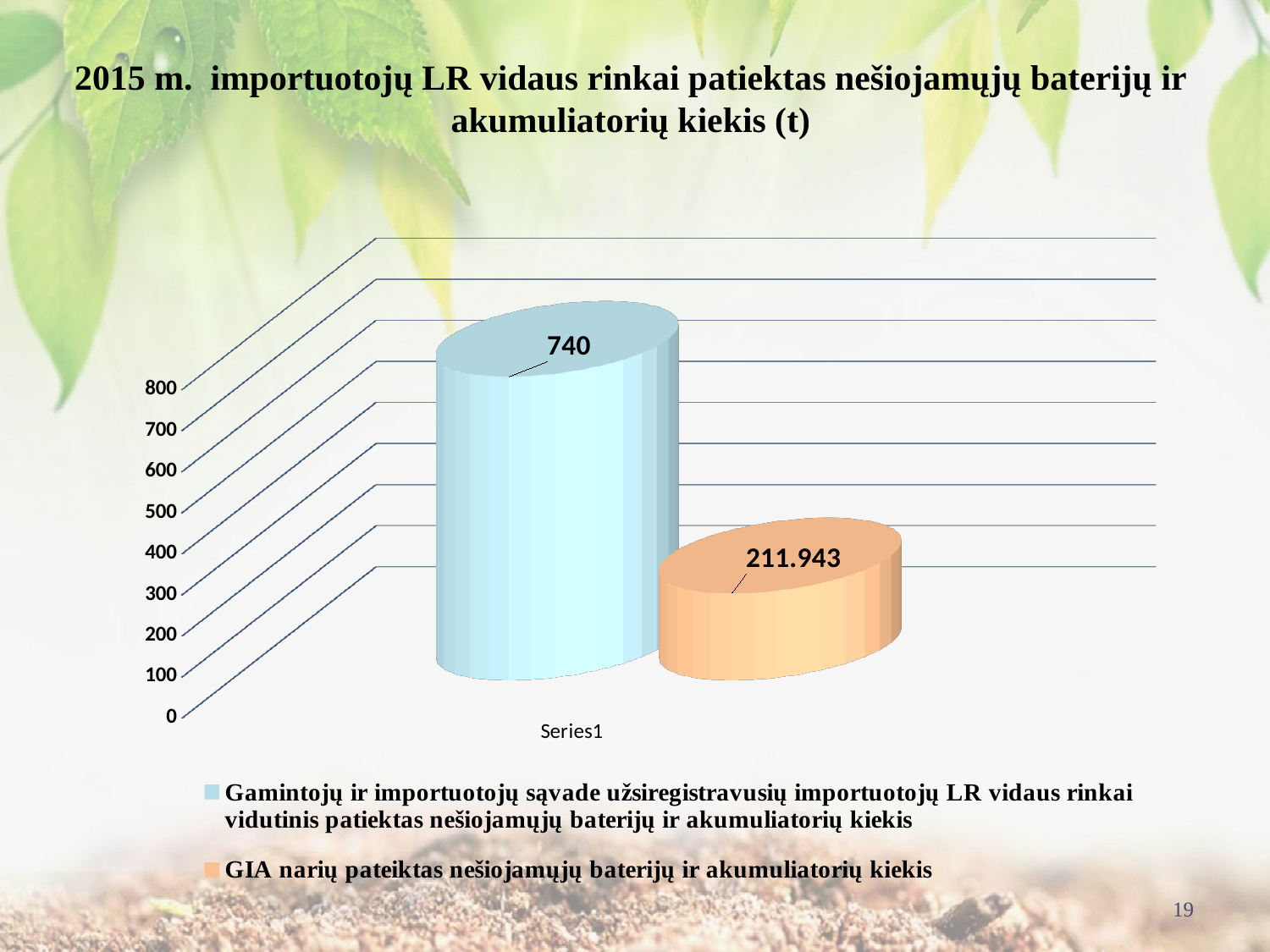
How many series does the legend list? 2 What kind of chart is shown on the slide? bar chart Is the value for the blue series larger or smaller than the value for the orange series? larger Which series has the lower value? GIA narių pateiktas nešiojamųjų baterijų ir akumuliatorių kiekis What value is shown for the series 'Gamintojų ir importuotojų sąvade užsiregistravusių importuotojų LR vidaus rinkai vidutinis patiektas nešiojamųjų baterijų ir akumuliatorių kiekis'? 740 What is the category label shown on the x axis? Series1 What is the difference between the two plotted values, 740 and 211.943? 528.057 What is the highest value shown on the vertical axis? 800 What value is shown for the series 'GIA narių pateiktas nešiojamųjų baterijų ir akumuliatorių kiekis'? 211.943 Which series has the higher value? Gamintojų ir importuotojų sąvade užsiregistravusių importuotojų LR vidaus rinkai vidutinis patiektas nešiojamųjų baterijų ir akumuliatorių kiekis Is the value for the blue series greater or less than 700? greater Is the value for 'GIA narių pateiktas nešiojamųjų baterijų ir akumuliatorių kiekis' greater or less than 300? less